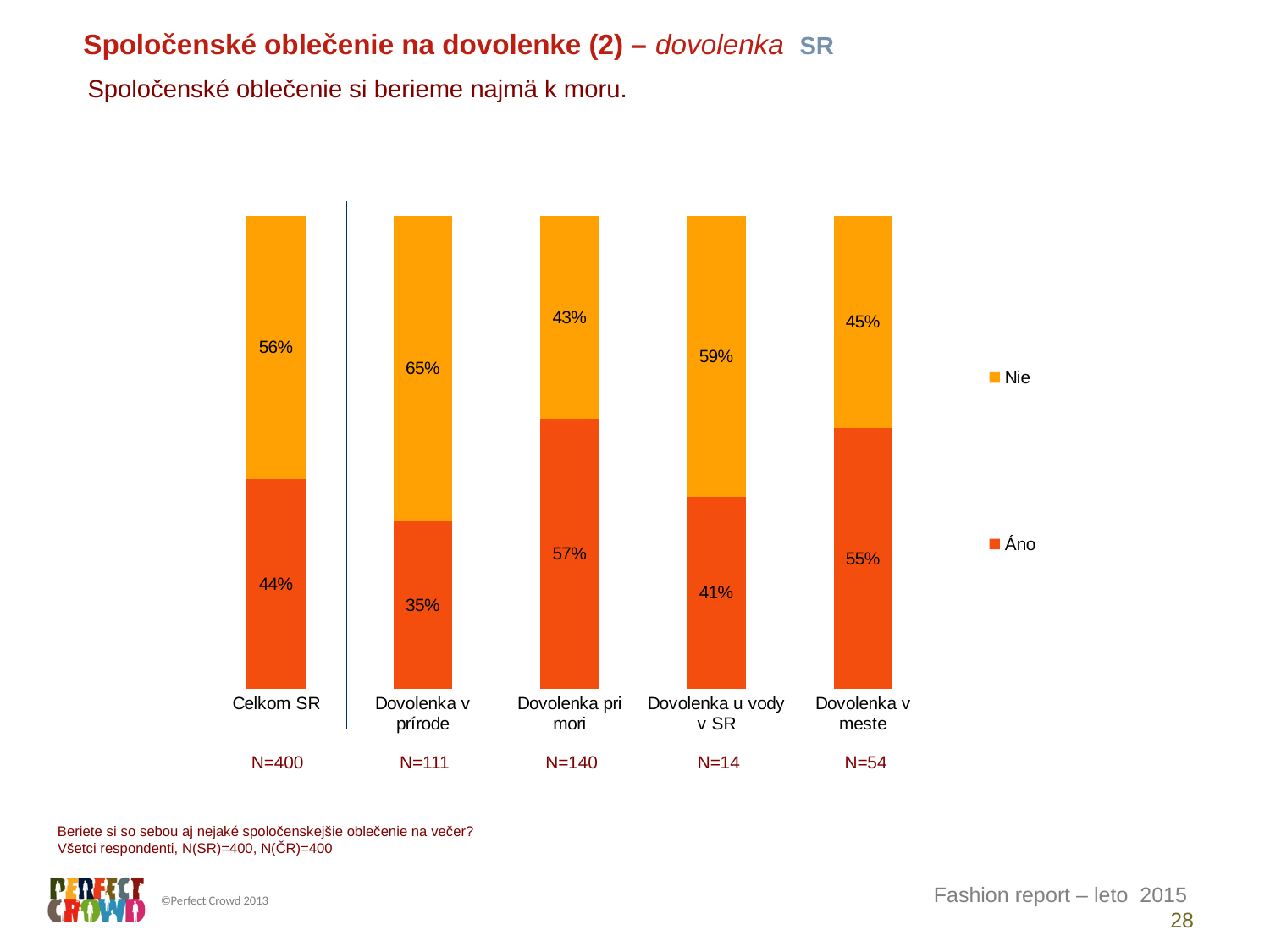
What is the 'Áno' value for Celkom SR? 44% What kind of chart is shown on the slide? Stacked bar chart What is the 'Nie' value for Dovolenka u vody v SR? 59% Which is larger: the 'Nie' value for Dovolenka v meste or the 'Nie' value for Celkom SR? Celkom SR How many series does the legend list? 2 What is the difference between the 'Áno' values for Dovolenka pri mori and Dovolenka v prírode? 22 percentage points What is the sample size (N) shown for Dovolenka pri mori? N=140 What is the 'Nie' value for Dovolenka v prírode? 65% How many categories are shown on the x axis? 5 Which category has the highest 'Áno' value? Dovolenka pri mori What is the 'Áno' value for Dovolenka pri mori? 57% Which category has the lowest 'Áno' value? Dovolenka v prírode